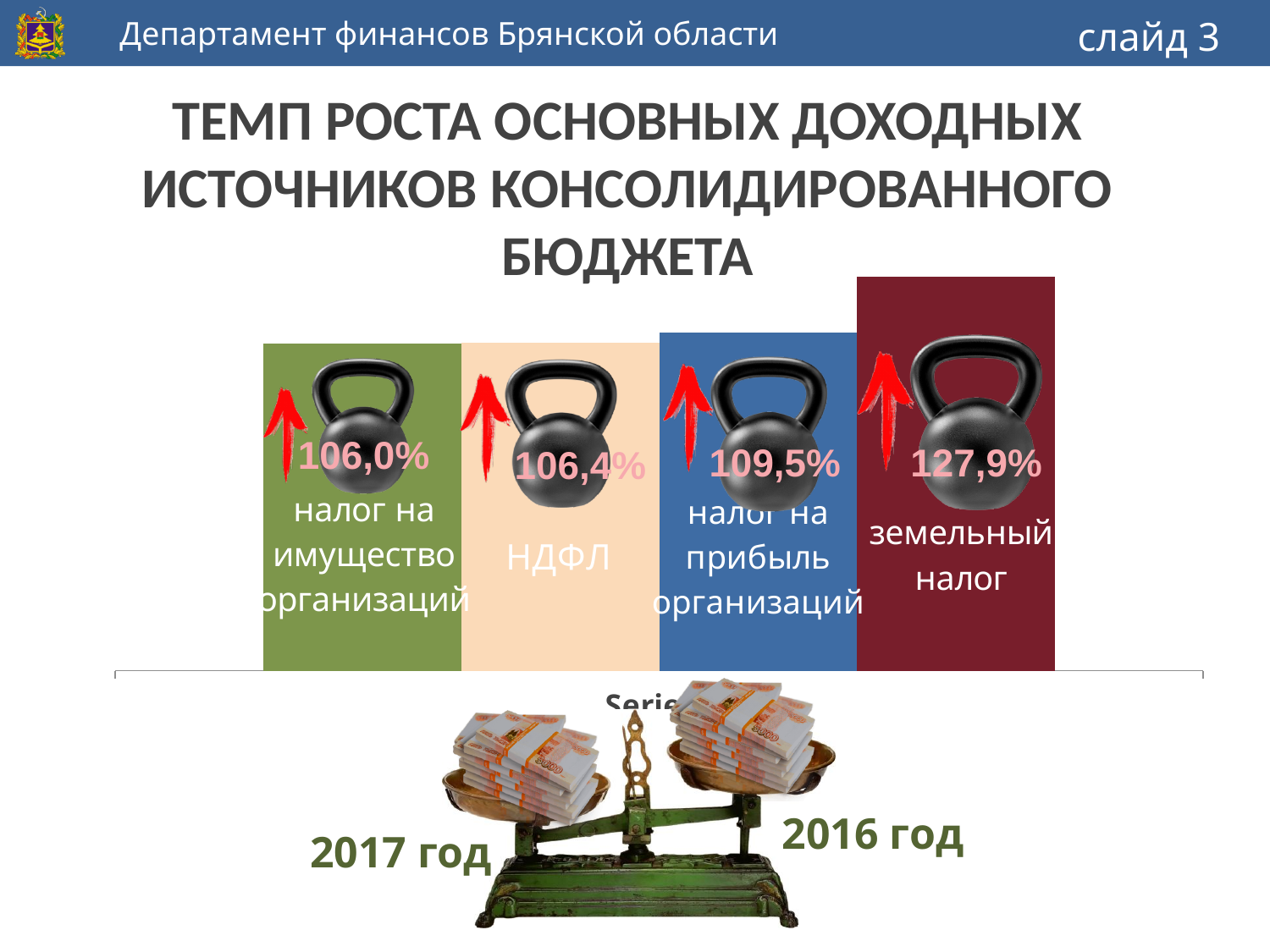
How many revenue sources (bars) are shown on the chart? 4 Do the values rise or fall moving from left to right across the bars? rise What is the difference between the growth rates of земельный налог and налог на прибыль организаций? 18,4% Which has a higher growth rate, налог на прибыль организаций or НДФЛ? налог на прибыль организаций What is the growth rate shown for НДФЛ? 106,4% What is the difference between the growth rates of НДФЛ and налог на имущество организаций? 0,4% What type of chart is used on the slide? bar chart What is the growth rate shown for земельный налог? 127,9% What is the growth rate shown for налог на прибыль организаций? 109,5% Which revenue source has the lowest growth rate on the chart? налог на имущество организаций Which revenue source has the highest growth rate on the chart? земельный налог What is the growth rate shown for налог на имущество организаций? 106,0%